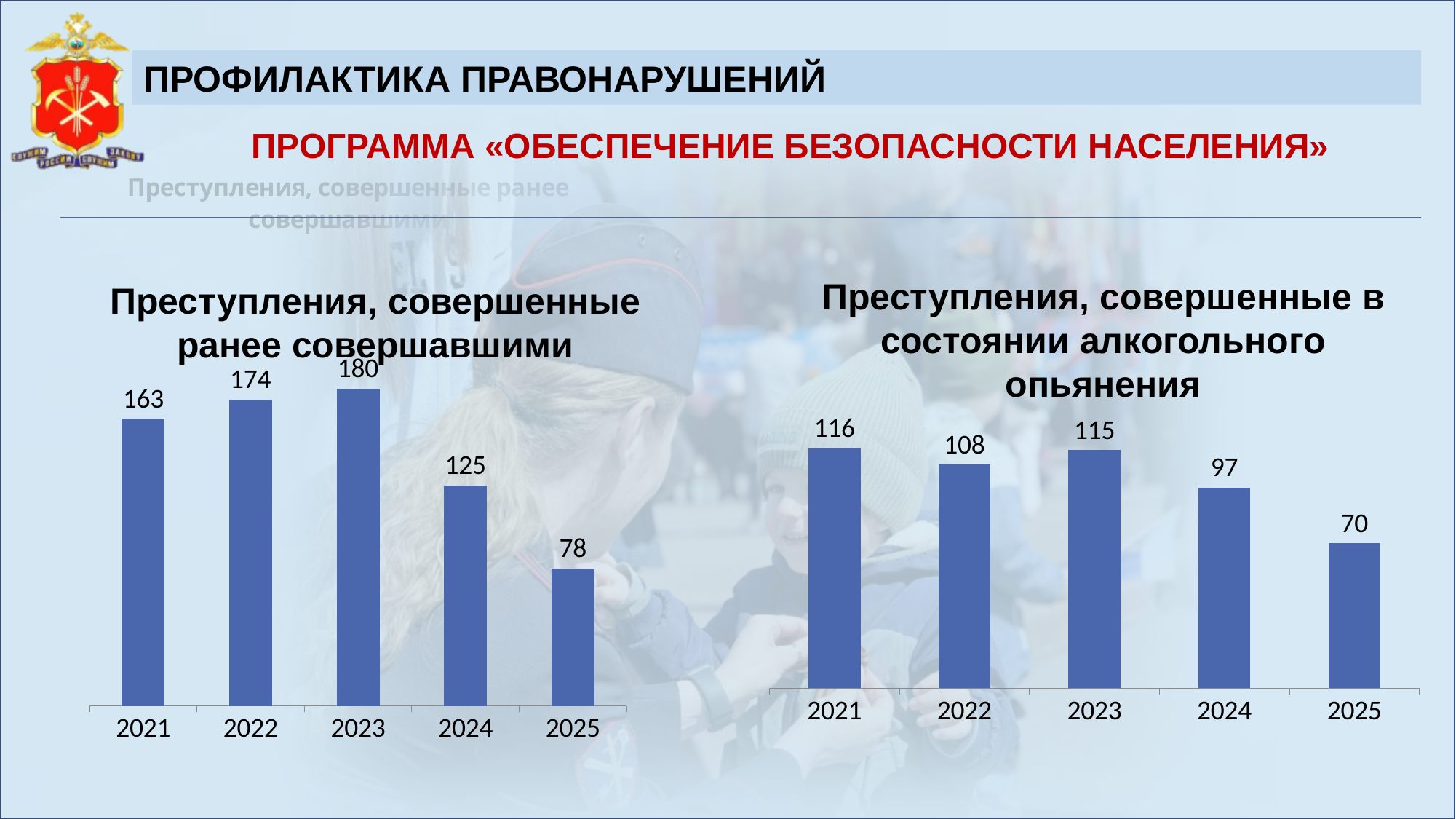
In the right chart 'Преступления, совершенные в состоянии алкогольного опьянения', what is the value for 2021? 116 In the left chart 'Преступления, совершенные ранее совершавшими', which year has the lowest value? 2025 In the left chart 'Преступления, совершенные ранее совершавшими', which year has the highest value? 2023 In the right chart 'Преступления, совершенные в состоянии алкогольного опьянения', which is larger, the value for 2022 or the value for 2024? 2022 In the left chart 'Преступления, совершенные ранее совершавшими', what is the difference between the values for 2021 and 2022? 11 In the right chart 'Преступления, совершенные в состоянии алкогольного опьянения', what is the difference between the values for 2021 and 2025? 46 How many years are shown on the x axis of the left chart 'Преступления, совершенные ранее совершавшими'? 5 In the right chart 'Преступления, совершенные в состоянии алкогольного опьянения', which year has the lowest value? 2025 What kind of chart is the right chart 'Преступления, совершенные в состоянии алкогольного опьянения'? Bar chart In the left chart 'Преступления, совершенные ранее совершавшими', what is the value for 2023? 180 In the left chart 'Преступления, совершенные ранее совершавшими', what is the value for 2025? 78 In the right chart 'Преступления, совершенные в состоянии алкогольного опьянения', what is the value for 2024? 97